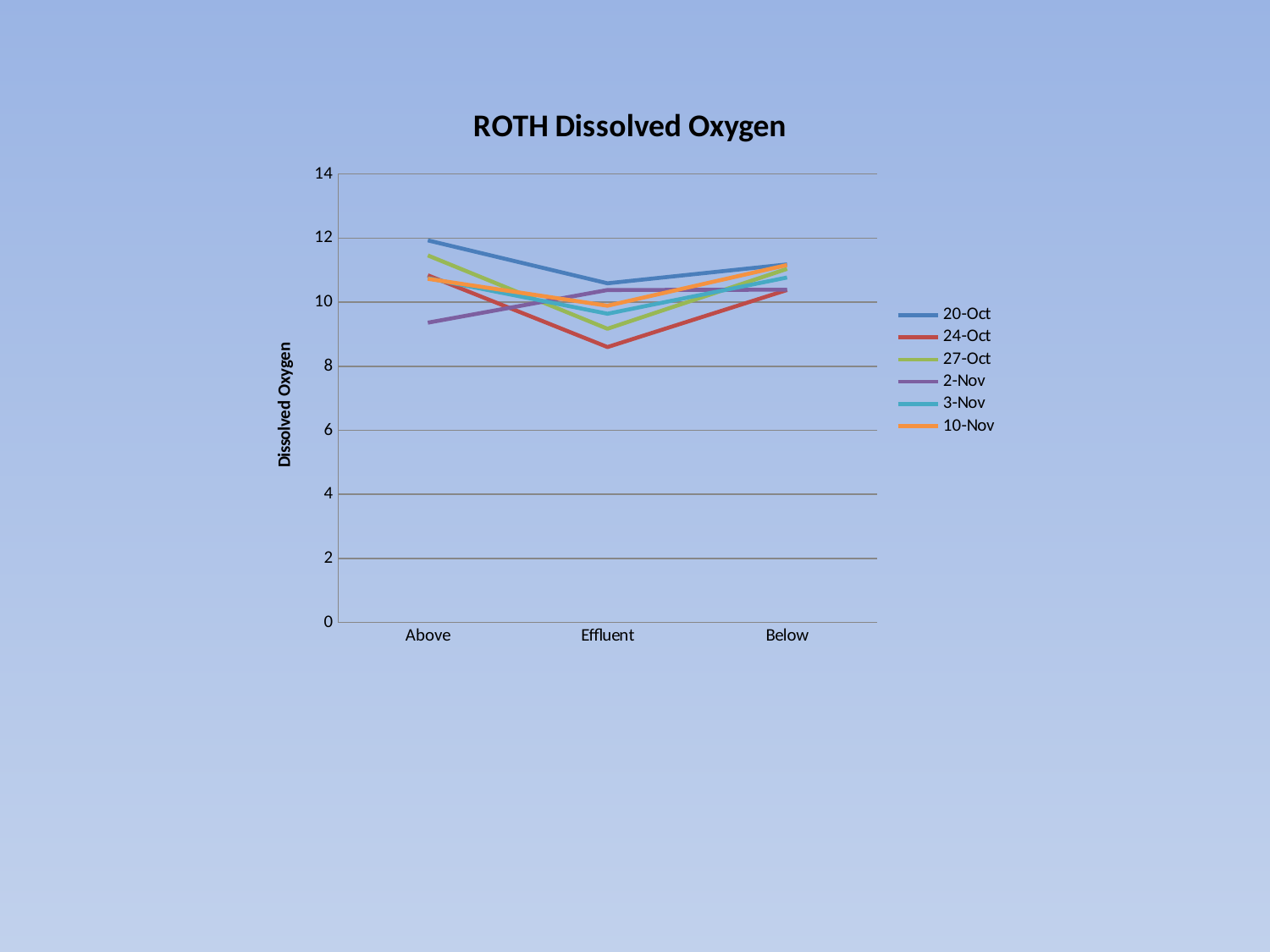
How many series does the legend list? 6 Is the value for 2-Nov at Above greater or less than 10? less What kind of chart is shown on the slide? line chart Which series has the lowest value at Effluent? 24-Oct What is the title of the chart? ROTH Dissolved Oxygen Which series has the lowest value at Above? 2-Nov Is the value for 20-Oct at Above greater or less than 10? greater How many categories are shown on the x axis? 3 Is the value for 24-Oct at Effluent greater or less than 10? less Which series has the highest value at Above? 20-Oct What is the label of the vertical axis? Dissolved Oxygen At Effluent, which is larger: the value for 20-Oct or the value for 24-Oct? 20-Oct